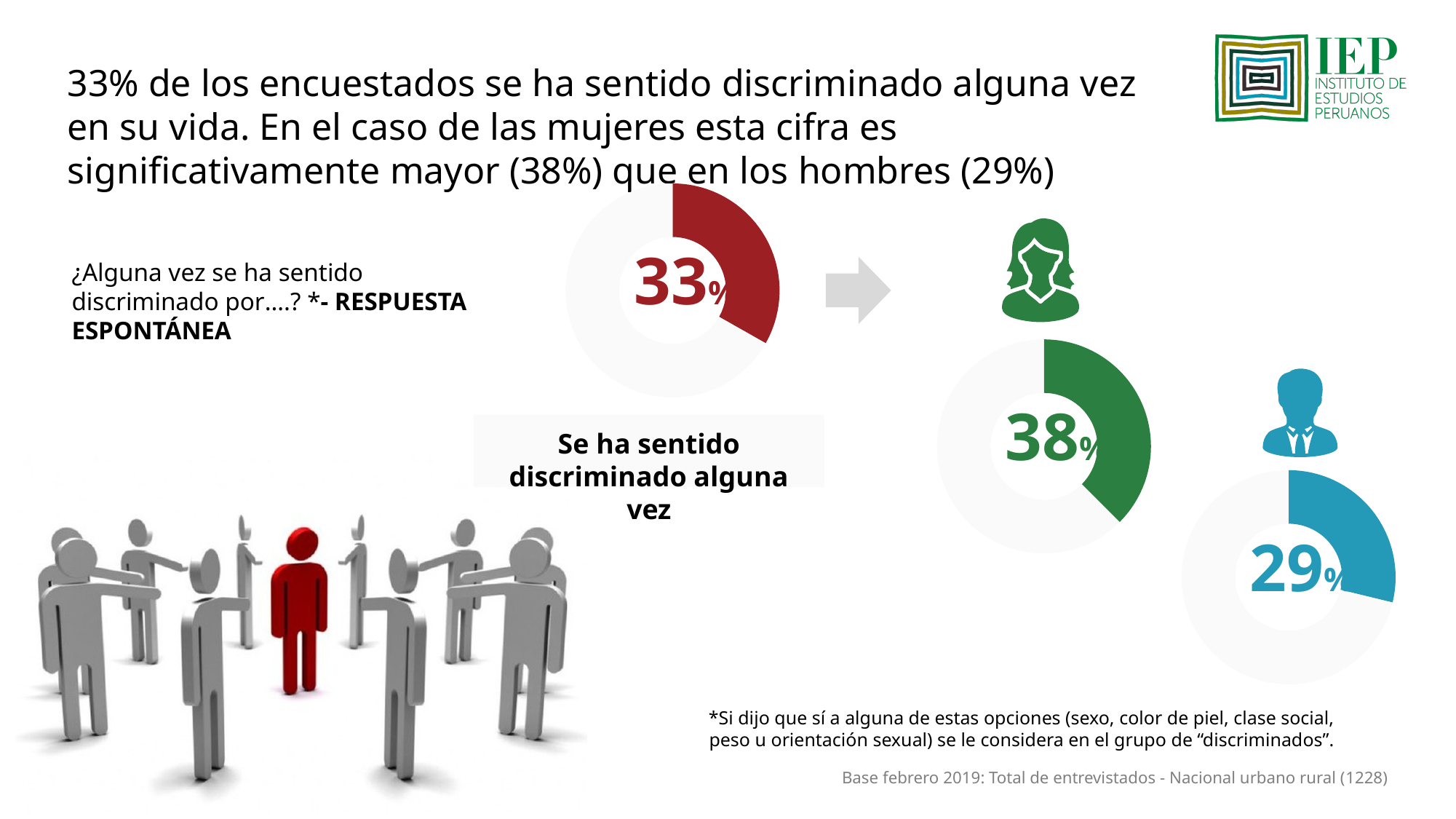
What is the difference in percentage points between the overall value (red chart) and the men's value (blue chart)? 4 What colour is the donut chart showing the men's value of 29%? Blue How many donut charts are shown on the slide? 3 Which group has the higher share of people who have felt discriminated against, women (green chart) or men (blue chart)? Women What is the difference in percentage points between the women's value (green chart) and the overall value (red chart)? 5 What percentage is shown in the green donut chart next to the woman icon? 38% What is the difference in percentage points between the women's value (green chart) and the men's value (blue chart)? 9 Of the three donut charts on the slide, which shows the lowest percentage? The blue chart for men (29%) What percentage is shown in the blue donut chart next to the man icon? 29% What type of chart is used to display the 33%, 38% and 29% values? Donut chart What percentage is shown in the red donut chart for all respondents who have ever felt discriminated against? 33% Of the three donut charts on the slide, which shows the highest percentage? The green chart for women (38%)